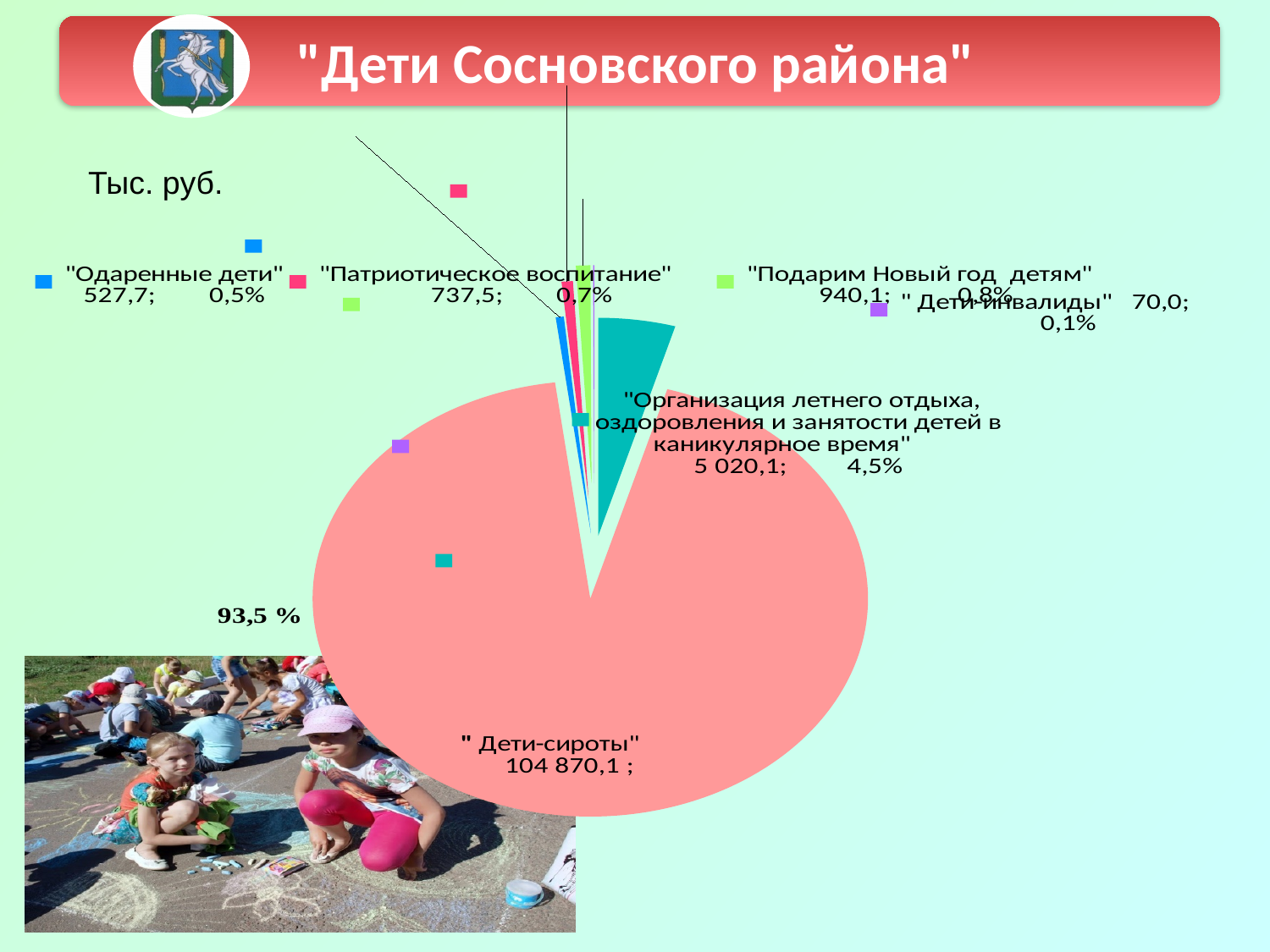
How many slices does the pie chart have? 6 What is the value for "Одаренные дети"? 527,7 What unit is stated for the values in the chart? Тыс. руб. What is the value for "Дети-сироты"? 104 870,1 What share of the pie does "Дети-сироты" take? 93,5 % What is the value for "Подарим Новый год детям"? 940,1 Which category has the largest slice of the pie? "Дети-сироты" Which category has the smallest slice of the pie? "Дети-инвалиды" What kind of chart is shown on the slide? pie chart What is the value for "Патриотическое воспитание"? 737,5 What share of the pie does "Организация летнего отдыха, оздоровления и занятости детей в каникулярное время" take? 4,5% What is the value for "Дети-инвалиды"? 70,0